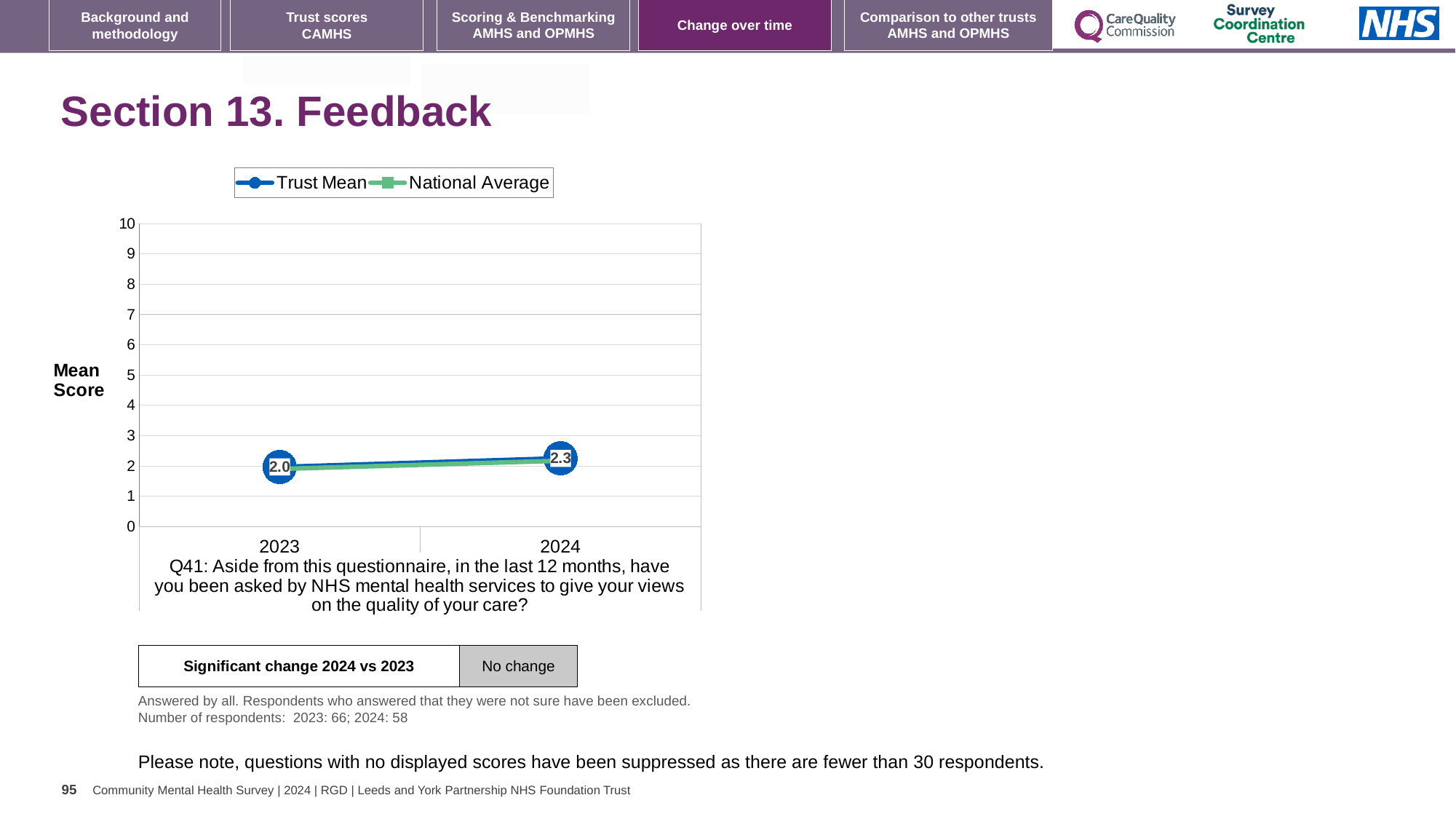
Does the Trust Mean rise or fall from 2023 to 2024? rise How many years are plotted on the x axis? 2 What is the Trust Mean value for 2023? 2.0 What is the difference between the Trust Mean in 2024 and in 2023? 0.3 What is the Trust Mean value for 2024? 2.3 What are the two series named in the legend? Trust Mean and National Average How many series does the legend list? 2 What kind of chart is shown on the slide? line chart What is the label on the y axis of the chart? Mean Score Which year has the higher Trust Mean, 2023 or 2024? 2024 What is the highest value shown on the y axis? 10 Is the Trust Mean for 2024 greater or less than 5? less